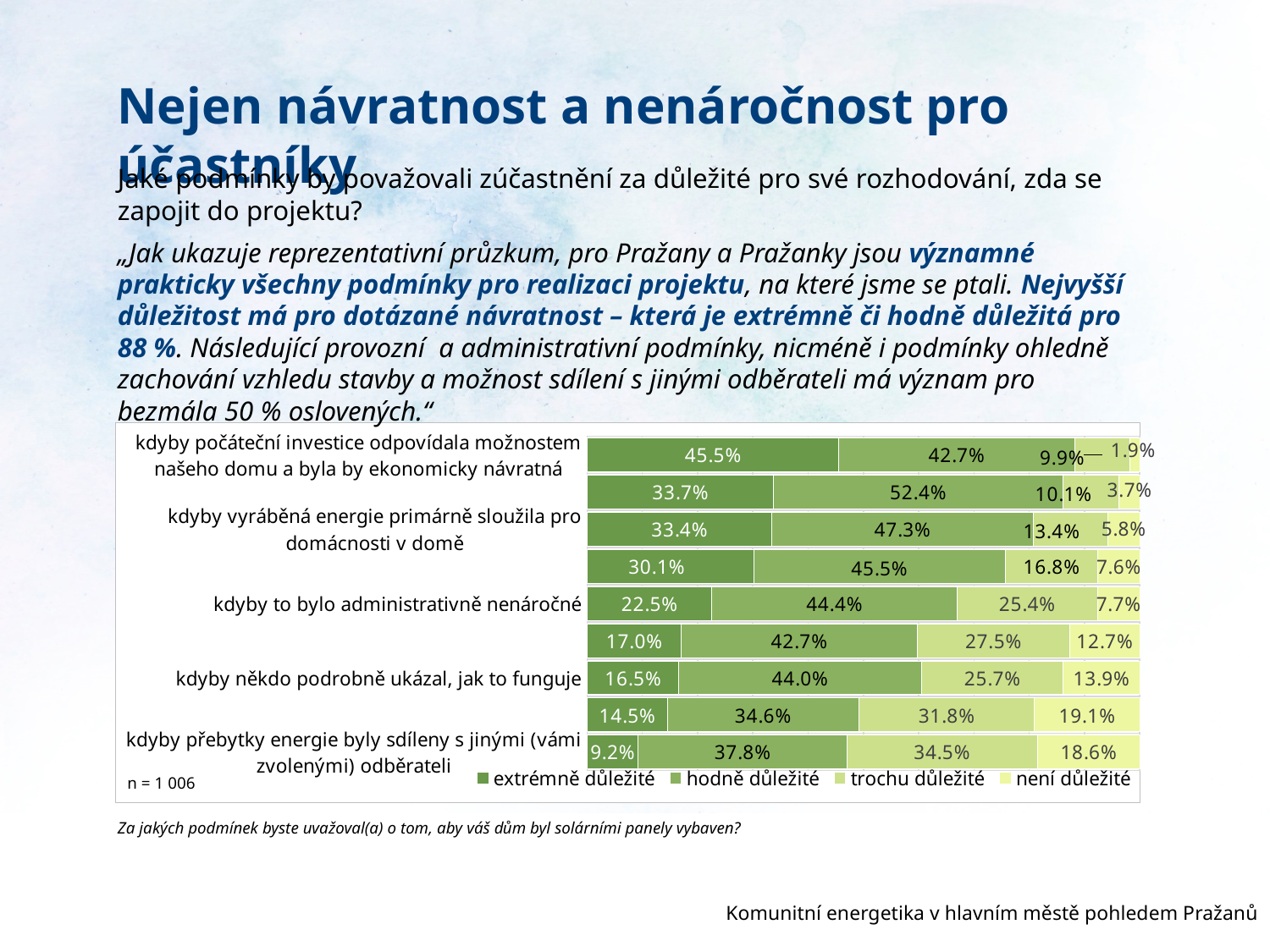
What kind of chart is shown on the slide? Stacked bar chart How many bars (conditions) are plotted in the chart? 9 Which condition has the highest 'extrémně důležité' share? kdyby počáteční investice odpovídala možnostem našeho domu a byla by ekonomicky návratná What is the 'není důležité' value for 'kdyby někdo podrobně ukázal, jak to funguje'? 13.9% What is the difference between the 'není důležité' values for 'kdyby přebytky energie byly sdíleny s jinými (vámi zvolenými) odběrateli' and 'kdyby počáteční investice odpovídala možnostem našeho domu a byla by ekonomicky návratná'? 16.7 percentage points Which has a larger 'extrémně důležité' share: 'kdyby vyráběná energie primárně sloužila pro domácnosti v domě' or 'kdyby to bylo administrativně nenáročné'? kdyby vyráběná energie primárně sloužila pro domácnosti v domě What is the 'hodně důležité' value for 'kdyby vyráběná energie primárně sloužila pro domácnosti v domě'? 47.3% What is the 'trochu důležité' value for 'kdyby to bylo administrativně nenáročné'? 25.4% What is the 'extrémně důležité' value for 'kdyby počáteční investice odpovídala možnostem našeho domu a byla by ekonomicky návratná'? 45.5% Which condition has the lowest 'extrémně důležité' share? kdyby přebytky energie byly sdíleny s jinými (vámi zvolenými) odběrateli What is the 'extrémně důležité' value for 'kdyby přebytky energie byly sdíleny s jinými (vámi zvolenými) odběrateli'? 9.2% How many series does the chart legend list? 4